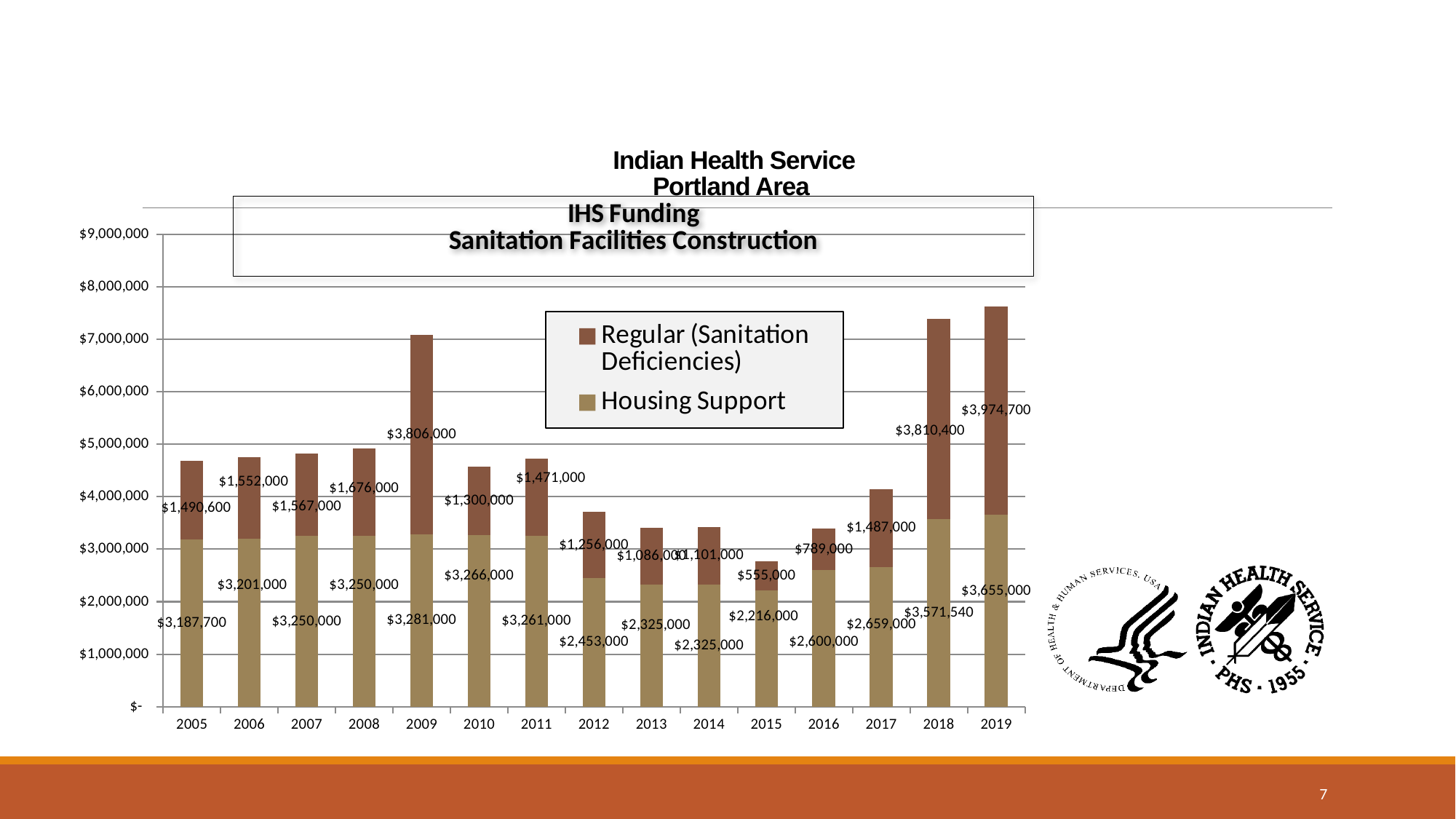
Which year has the highest Regular (Sanitation Deficiencies) value? 2019 What is the total of the stacked bar for 2015? $2,771,000 What is the difference between the Regular (Sanitation Deficiencies) values for 2019 and 2018? $164,300 Which year has the lowest Regular (Sanitation Deficiencies) value? 2015 What is the Housing Support value for 2018? $3,571,540 What is the Housing Support value for 2005? $3,187,700 How many years are shown on the x axis? 15 How many series does the legend list? 2 What type of chart is shown on the slide? Stacked bar chart What is the Regular (Sanitation Deficiencies) value for 2009? $3,806,000 Which is larger, the Housing Support value for 2012 or for 2016? 2016 Is the total of the stacked bar for 2018 greater or less than $7,000,000? greater